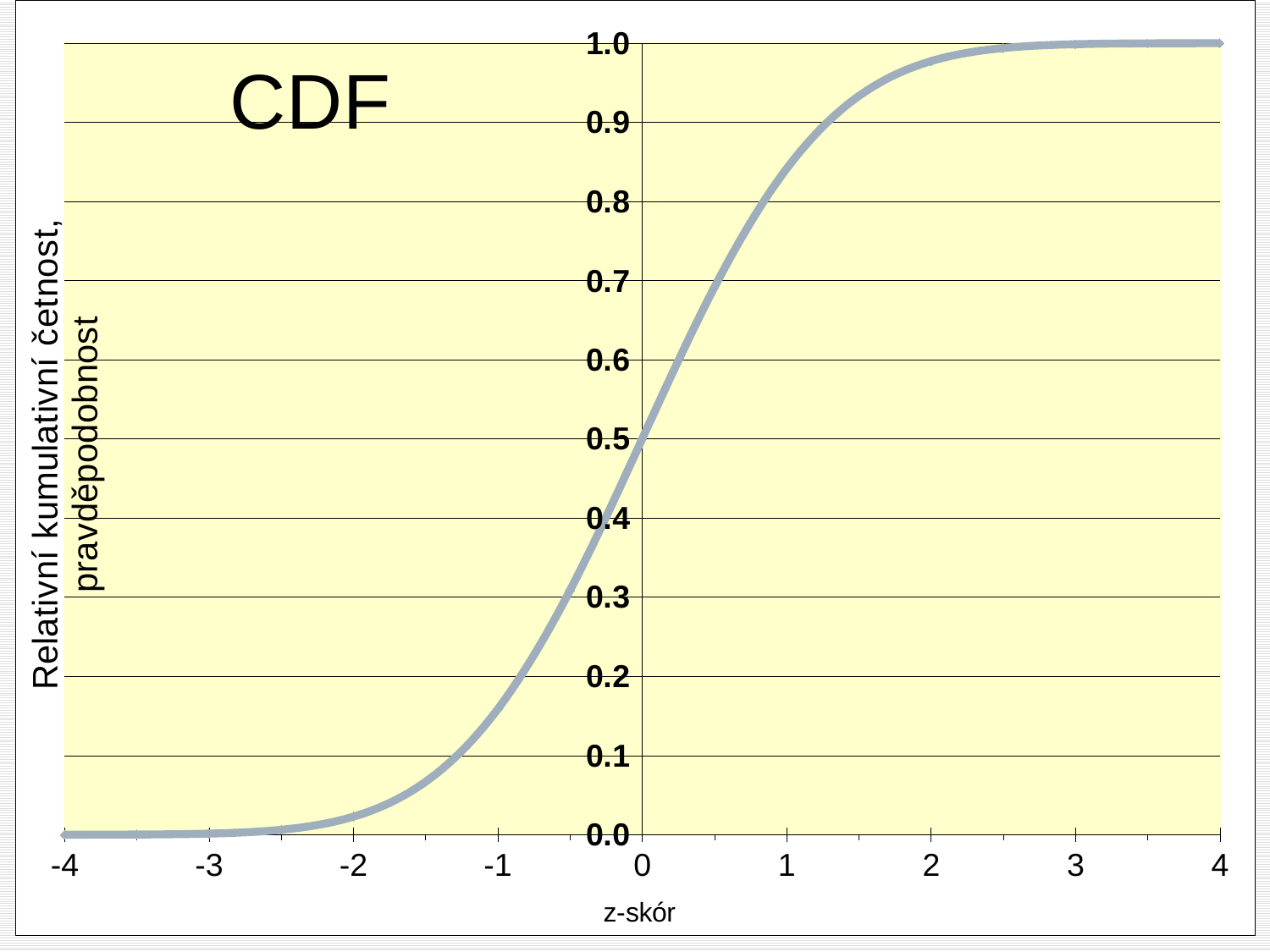
What kind of chart is shown on the slide? line chart Do the values rise or fall as the z-skór increases from -4 to 4? rise What is the title of the chart? CDF Is the value at z-skór -2 greater or less than 0.1? less Is the value at z-skór 2 greater or less than 0.9? greater At which z-skór shown on the x axis does the curve reach its highest value? 4 Is the value at z-skór -3 greater or less than 0.1? less What is the value of the curve at z-skór 0? 0.5 Which is larger, the value at z-skór 1 or the value at z-skór -1? z-skór 1 What is the label of the x axis? z-skór